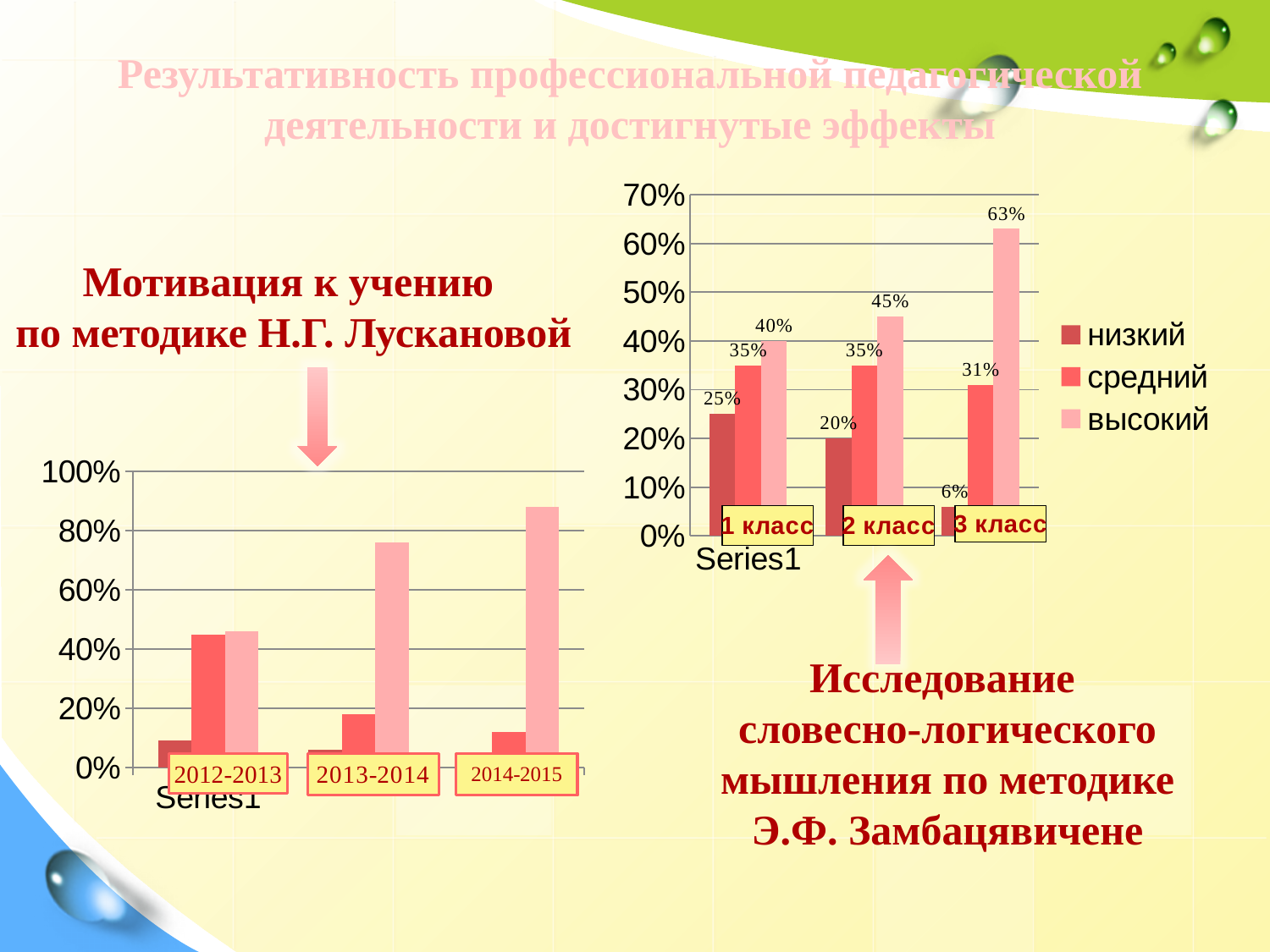
In the right chart (Исследование словесно-логического мышления), which class has the highest value for высокий? 3 класс In the right chart (Исследование словесно-логического мышления), what is the value for высокий in 3 класс? 63% In the right chart (Исследование словесно-логического мышления), how many class categories are shown on the x axis? 3 In the right chart (Исследование словесно-логического мышления), how many series does the legend list? 3 In the left chart (Мотивация к учению), is the value of the light pink bar for 2014-2015 greater or less than 80%? greater What kind of chart is the left chart (Мотивация к учению по методике Н.Г. Лускановой)? bar chart In the right chart (Исследование словесно-логического мышления), which class has the lowest value for низкий? 3 класс In the right chart (Исследование словесно-логического мышления), what is the value for низкий in 2 класс? 20% In the right chart (Исследование словесно-логического мышления), what is the value for средний in 1 класс? 35% In the right chart (Исследование словесно-логического мышления), which is larger in 2 класс: средний or высокий? высокий In the right chart (Исследование словесно-логического мышления), what is the difference between высокий and низкий in 3 класс? 57% In the left chart (Мотивация к учению), do the light pink bars rise or fall from 2012-2013 to 2014-2015? rise